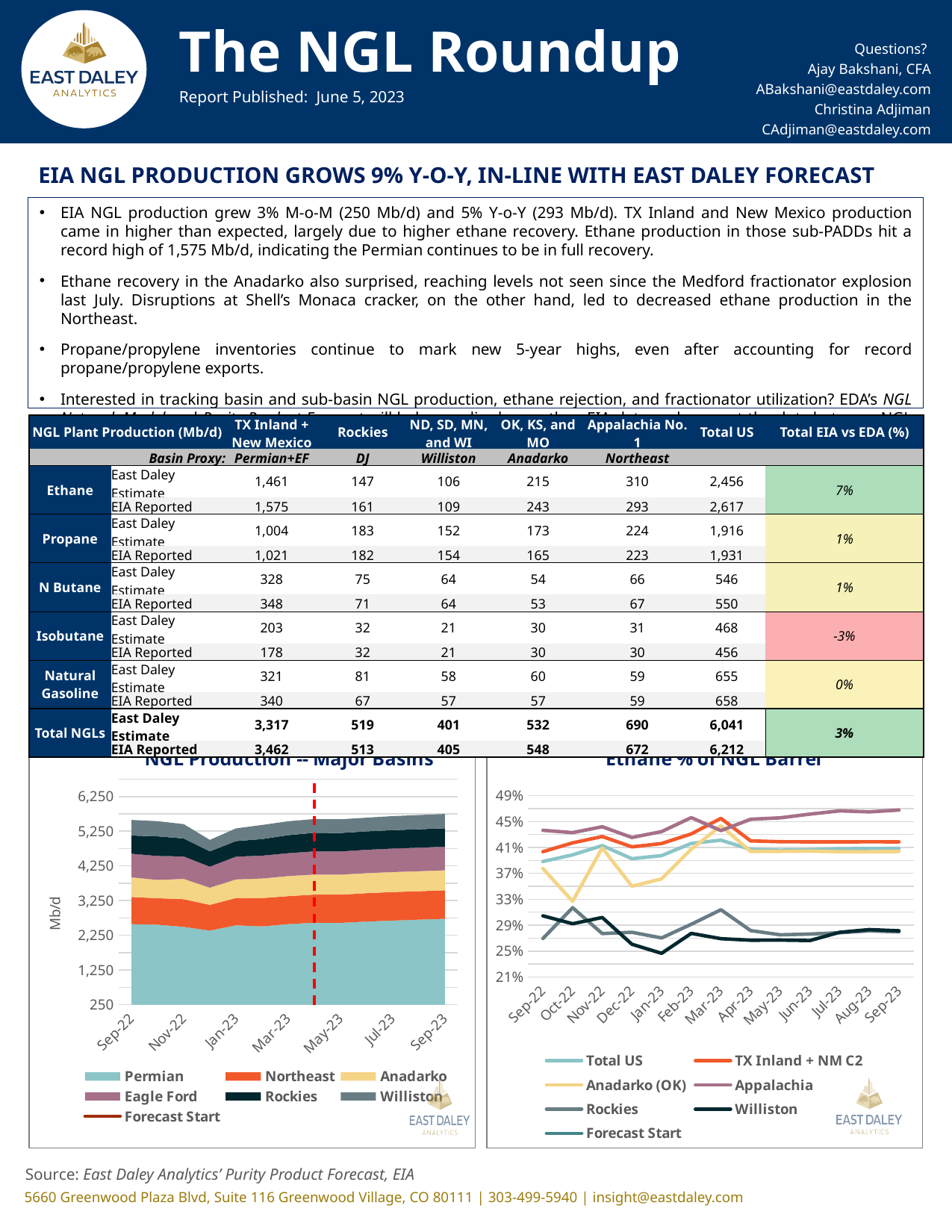
In the "NGL Production -- Major Basins" chart, what is the label on the vertical axis? Mb/d In the "Ethane % of NGL Barrel" chart, is the Anadarko (OK) value in Oct-22 greater or less than 37%? less In the "NGL Production -- Major Basins" chart, is the total stacked production in Sep-23 greater or less than 5,250 Mb/d? greater In the "Ethane % of NGL Barrel" chart, which series has the lowest value in Jan-23? Williston What kind of chart is the "Ethane % of NGL Barrel" chart on the right? line chart In the "Ethane % of NGL Barrel" chart, does the Appalachia line rise or fall from Sep-22 to Sep-23? rise How many entries does the legend of the "Ethane % of NGL Barrel" chart list? 7 In the "NGL Production -- Major Basins" chart, which basin has the largest production area? Permian In the "Ethane % of NGL Barrel" chart, is the Appalachia value in Sep-23 greater or less than 45%? greater How many entries does the legend of the "NGL Production -- Major Basins" chart list? 7 What kind of chart is the "NGL Production -- Major Basins" chart on the left? stacked area chart In the "Ethane % of NGL Barrel" chart, which series has the highest value in Sep-23? Appalachia